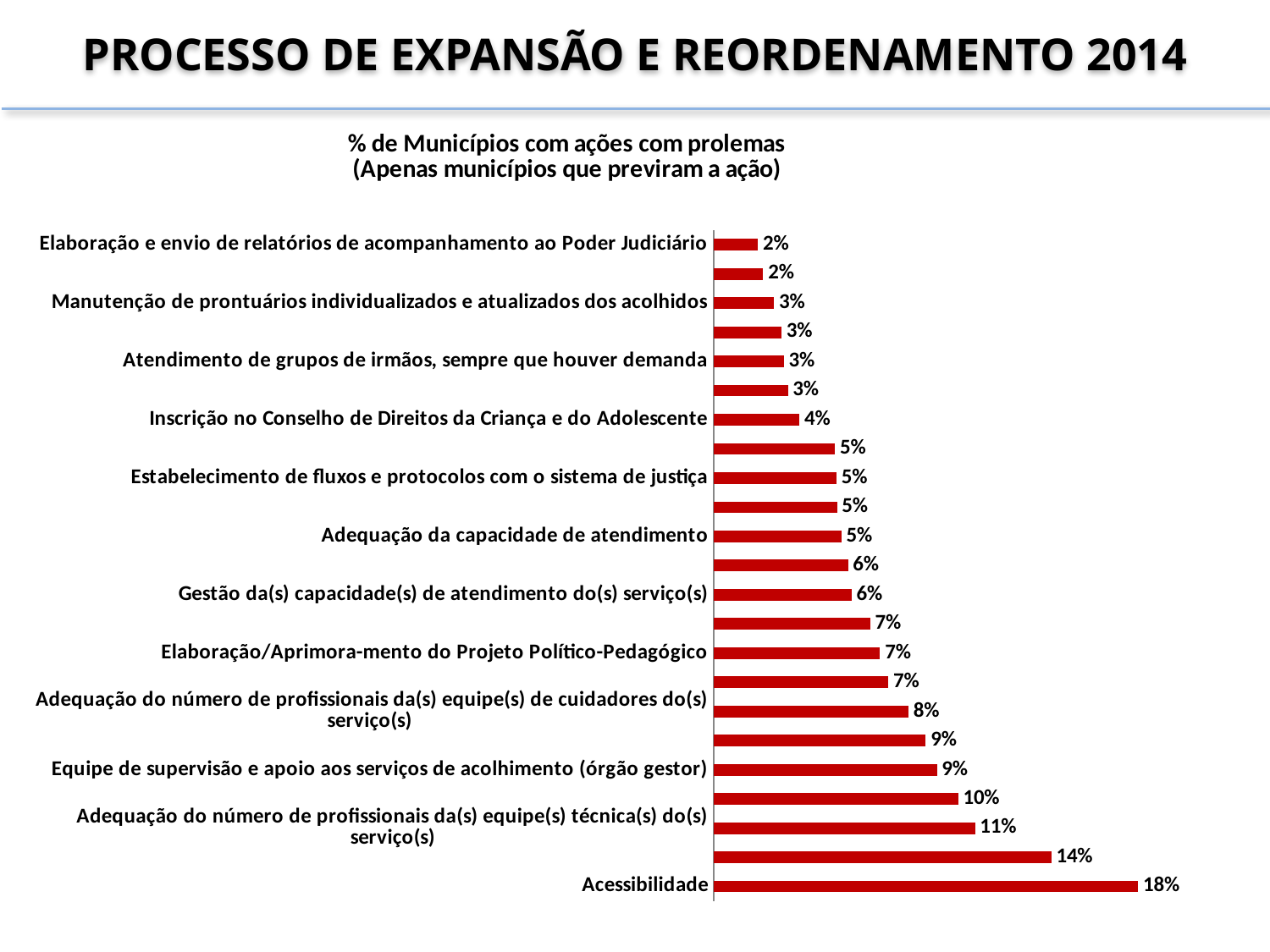
Which category has the highest value? Acessibilidade What type of chart is shown on the slide? bar chart What is the value for Elaboração e envio de relatórios de acompanhamento ao Poder Judiciário? 2% What is the value for Equipe de supervisão e apoio aos serviços de acolhimento (órgão gestor)? 9% What is the value for Acessibilidade? 18% How many bars are plotted in the chart? 23 What is the difference between the values for Acessibilidade and Adequação do número de profissionais da(s) equipe(s) técnica(s) do(s) serviço(s)? 7% What is the title of the chart? % de Municípios com ações com prolemas (Apenas municípios que previram a ação) What is the value for Adequação do número de profissionais da(s) equipe(s) técnica(s) do(s) serviço(s)? 11% Which is larger: the value for Gestão da(s) capacidade(s) de atendimento do(s) serviço(s) or the value for Adequação do número de profissionais da(s) equipe(s) de cuidadores do(s) serviço(s)? Adequação do número de profissionais da(s) equipe(s) de cuidadores do(s) serviço(s) What is the lowest value shown in the chart? 2% What is the value for Inscrição no Conselho de Direitos da Criança e do Adolescente? 4%